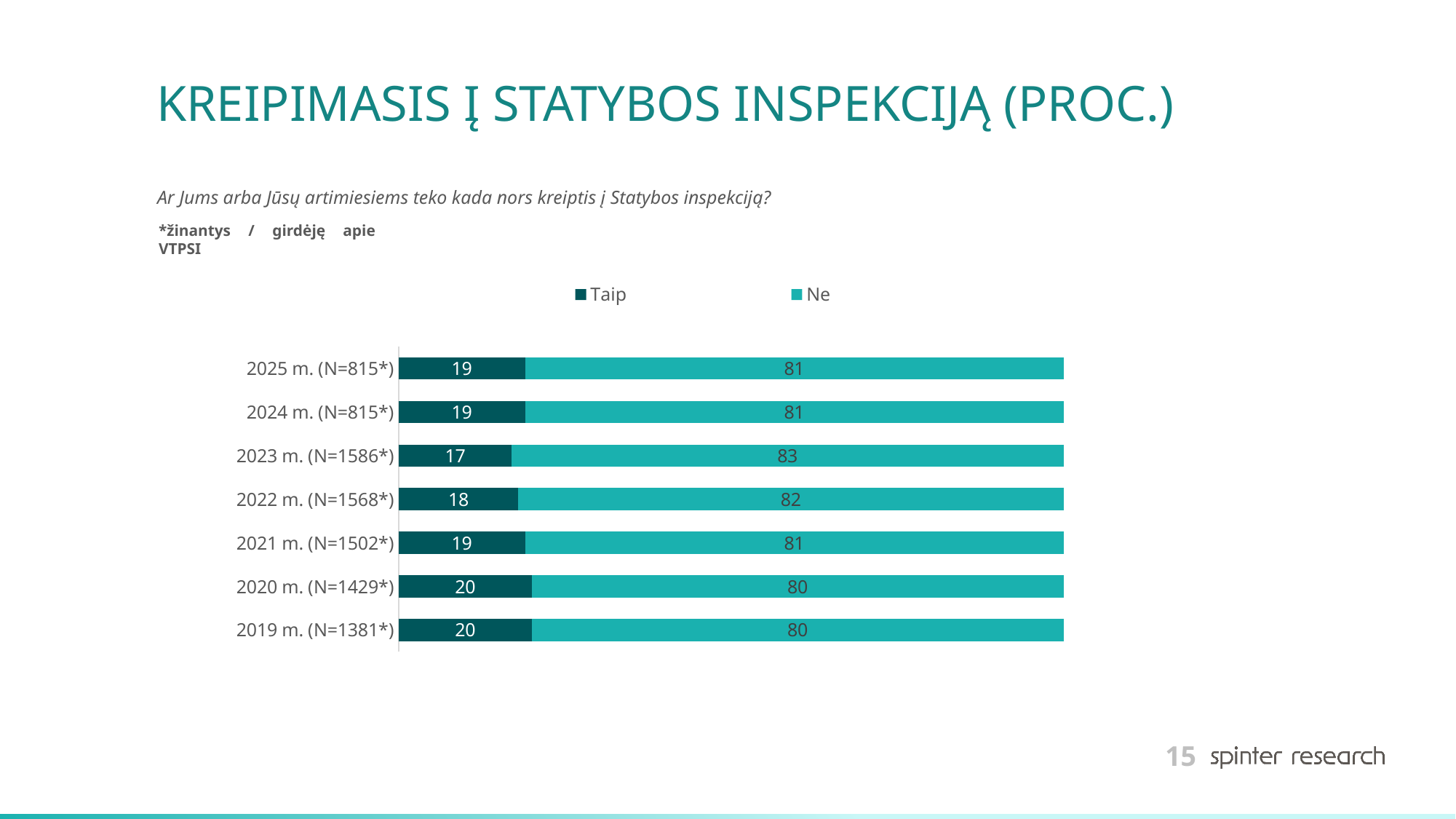
How many years (categories) are shown in the chart? 7 What is the "Taip" value for 2022 m. (N=1568*)? 18 Which year has the lowest "Taip" value? 2023 m. (N=1586*) What is the "Ne" value for 2023 m. (N=1586*)? 83 How many series does the legend list? 2 What is the "Taip" value for 2025 m. (N=815*)? 19 What is the difference between the "Ne" and "Taip" values for 2020 m. (N=1429*)? 60 What kind of chart is shown on the slide? Stacked bar chart Which year has the highest "Ne" value? 2023 m. (N=1586*) Is the "Taip" value larger for 2020 m. (N=1429*) or for 2023 m. (N=1586*)? 2020 m. (N=1429*) What is the total of the stacked bar for 2019 m. (N=1381*)? 100 What are the two legend entries of the chart? Taip, Ne